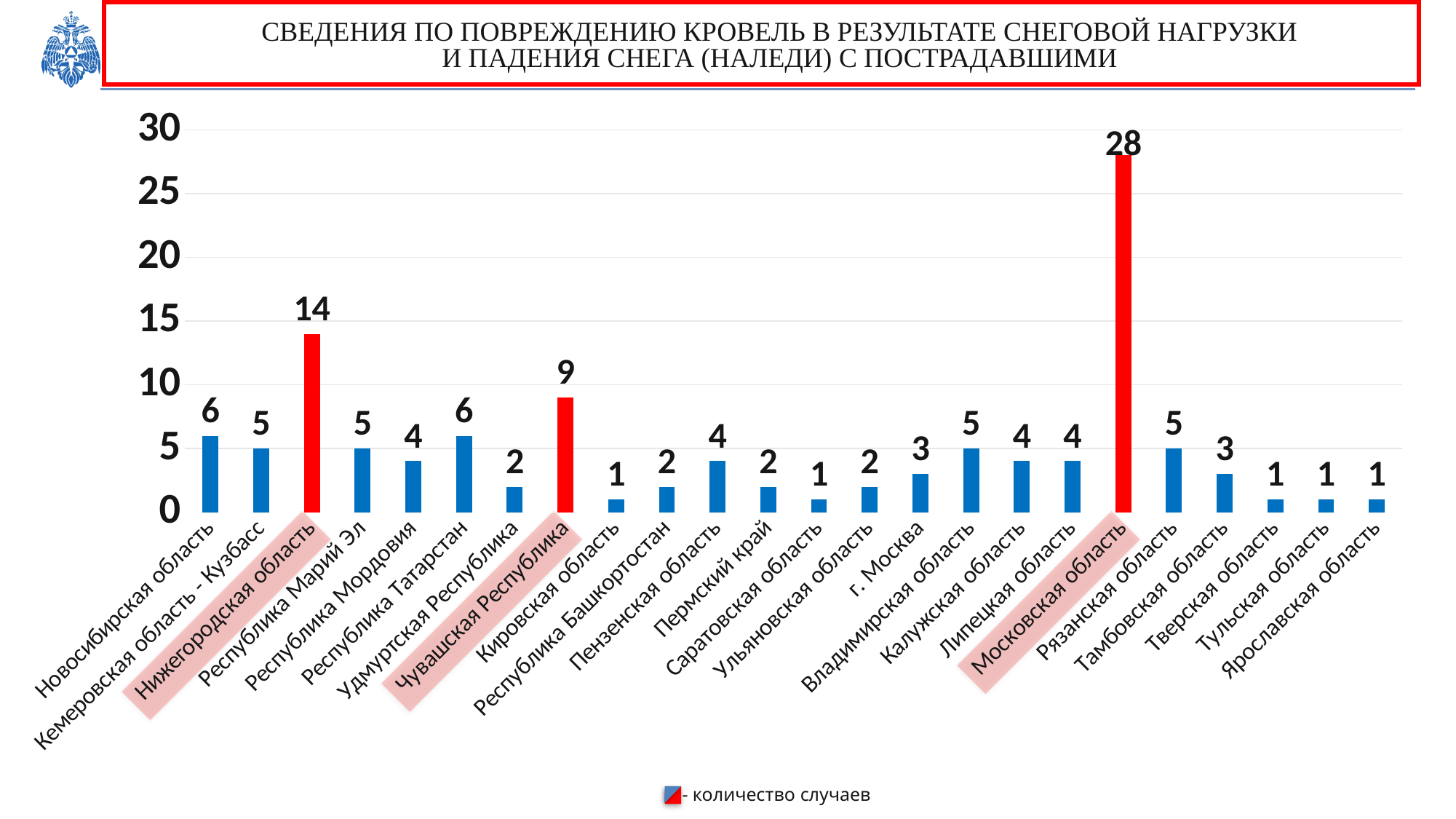
Which is larger, the value for Чувашская Республика or the value for Владимирская область? Чувашская Республика What is the value for Нижегородская область? 14 What is the value for Чувашская Республика? 9 What is the value for Московская область? 28 What is the value for Республика Татарстан? 6 How many bars are coloured red in the chart? 3 Is the value for Московская область greater or less than 25? greater Which region has the highest number of cases? Московская область What is the value for г. Москва? 3 How many regions are shown on the x axis of the chart? 24 What is the difference between the values for Московская область and Нижегородская область? 14 What type of chart is shown on the slide? bar chart